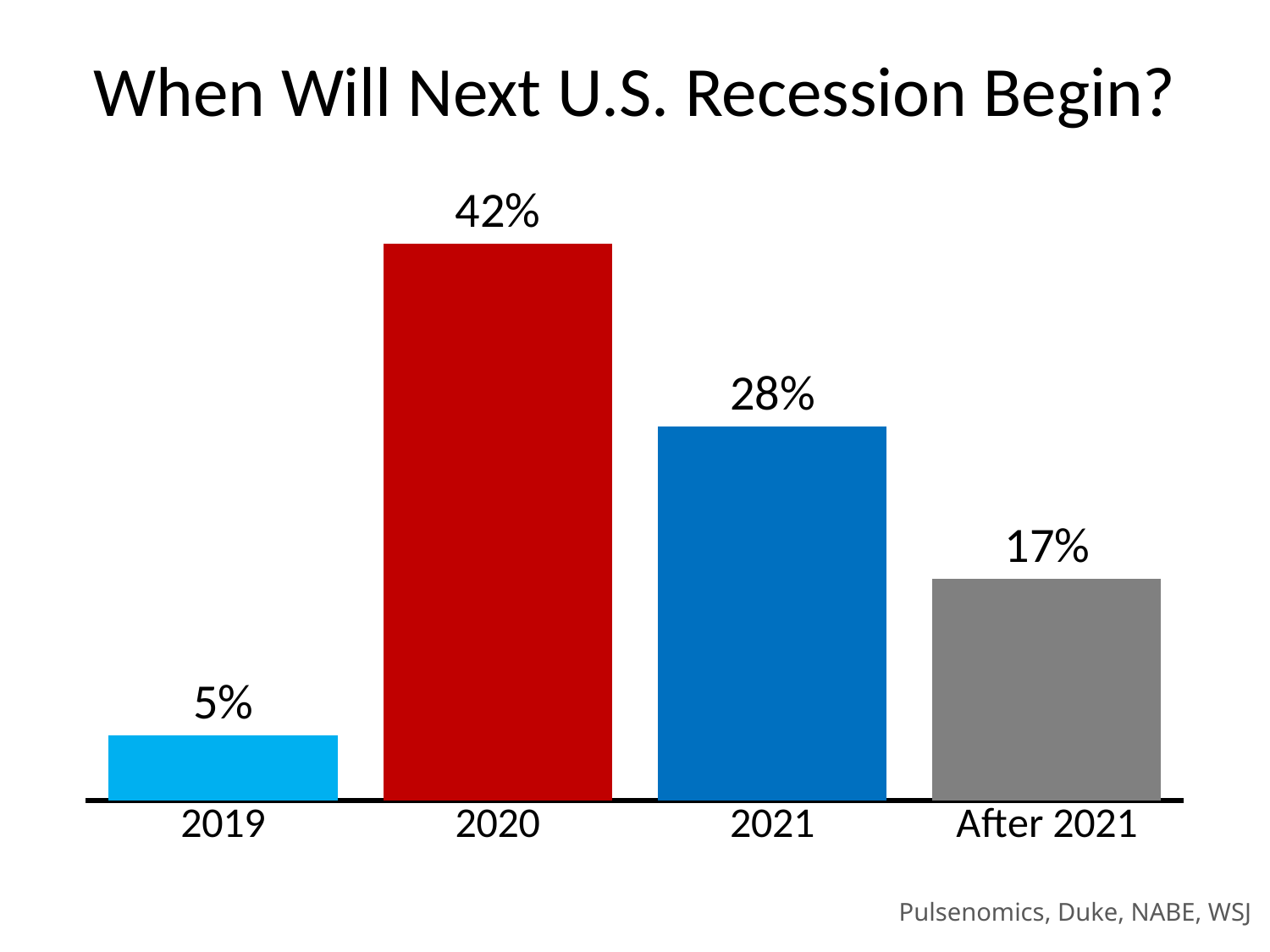
What is the value for 2020? 42% How many categories are shown on the chart? 4 What colour is the bar for 2020? Red What is the difference between the values for 2020 and 2021? 14% Which category has the lowest value? 2019 What is the value for 2019? 5% Which category has the highest value? 2020 Which is larger, the value for 2021 or the value for After 2021? 2021 What is the value for After 2021? 17% What is the difference between the values for 2021 and After 2021? 11% What kind of chart is this? Bar chart What is the title of the chart? When Will Next U.S. Recession Begin?